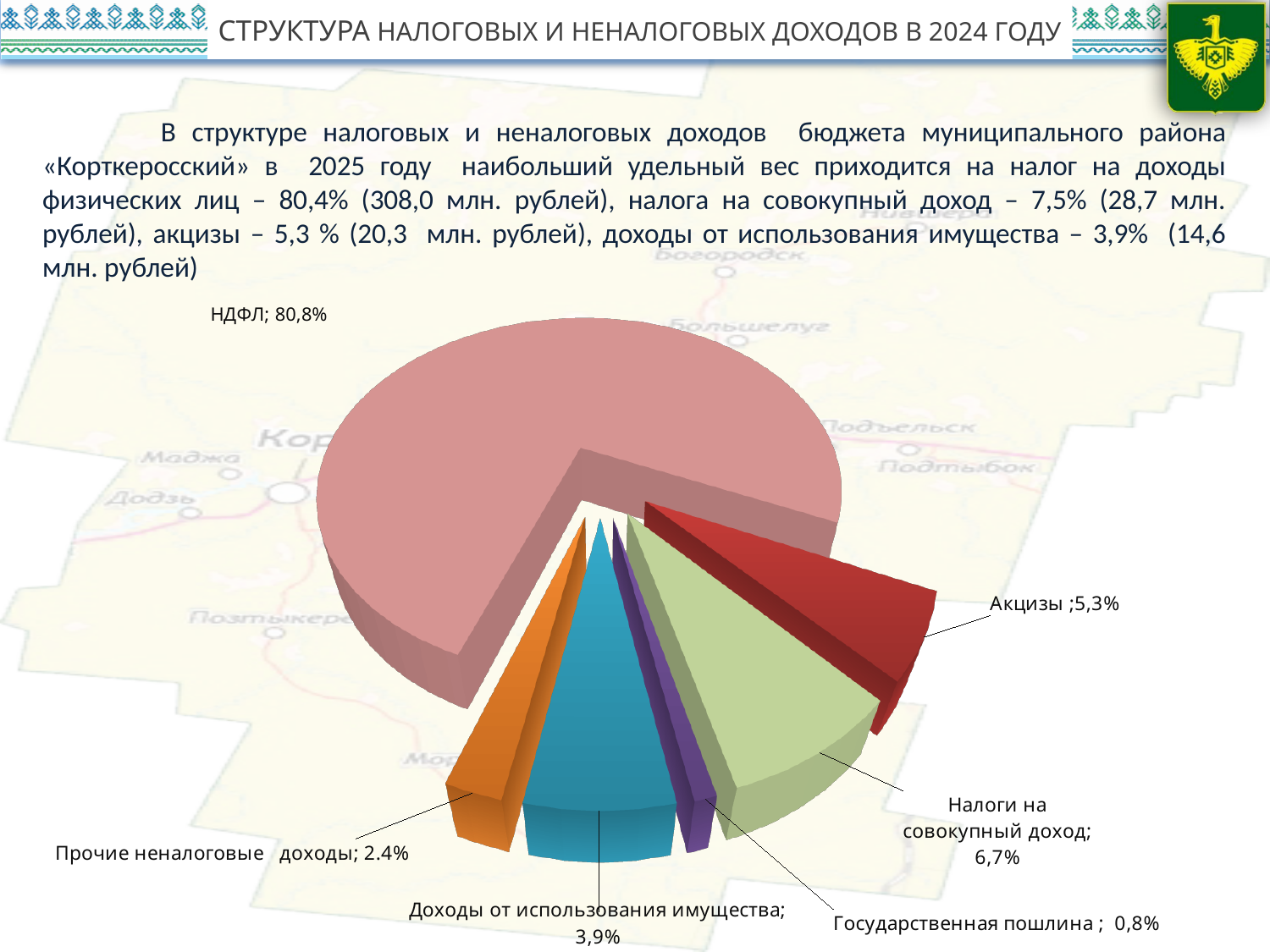
Which category has the smallest slice of the pie? Государственная пошлина What is the value shown for Акцизы? 5,3% What is the value shown for Прочие неналоговые доходы? 2.4% What is the value shown for Доходы от использования имущества? 3,9% What kind of chart is shown on the slide? pie chart Which is larger, the slice for Акцизы or the slice for Налоги на совокупный доход? Налоги на совокупный доход How many slices does the pie chart have? 6 What share of the pie does НДФЛ account for? 80,8% What is the value shown for Налоги на совокупный доход? 6,7% What is the value shown for Государственная пошлина? 0,8% What is the difference in percentage points between Налоги на совокупный доход and Акцизы? 1,4 Which category has the largest slice of the pie? НДФЛ